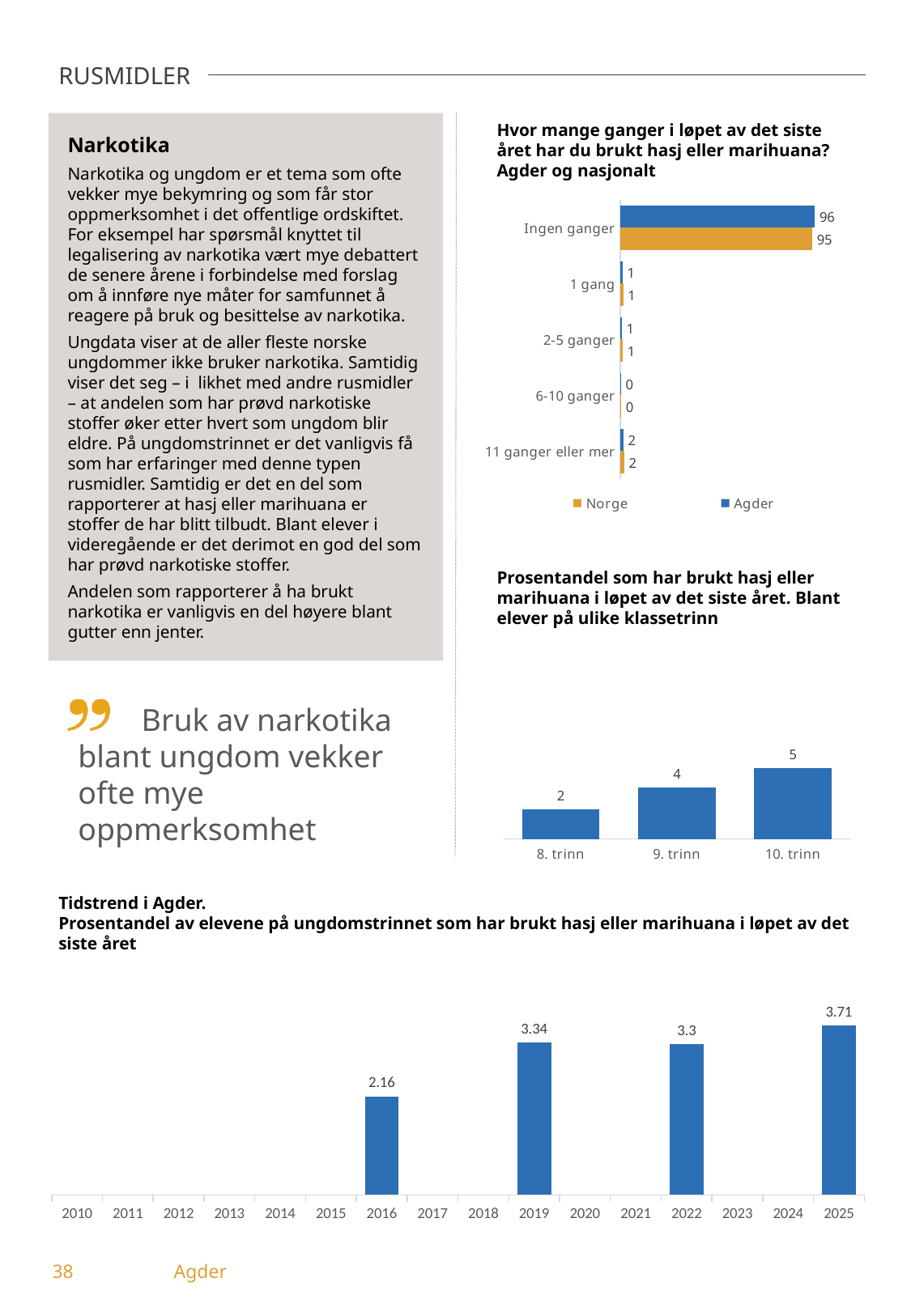
In the chart 'Hvor mange ganger i løpet av det siste året har du brukt hasj eller marihuana? Agder og nasjonalt', what is the value for Agder for '11 ganger eller mer'? 2 In the chart 'Prosentandel som har brukt hasj eller marihuana i løpet av det siste året. Blant elever på ulike klassetrinn', what is the difference between 10. trinn and 8. trinn? 3 In the chart 'Hvor mange ganger i løpet av det siste året har du brukt hasj eller marihuana? Agder og nasjonalt', what is the value for Agder for 'Ingen ganger'? 96 In the chart 'Tidstrend i Agder', which is larger, the value for 2022 or the value for 2025? 2025 In the chart 'Hvor mange ganger i løpet av det siste året har du brukt hasj eller marihuana? Agder og nasjonalt', how many categories are shown? 5 In the chart 'Tidstrend i Agder', which year has the lowest value? 2016 In the chart 'Hvor mange ganger i løpet av det siste året har du brukt hasj eller marihuana? Agder og nasjonalt', which colour represents Norge? Orange In the chart 'Hvor mange ganger i løpet av det siste året har du brukt hasj eller marihuana? Agder og nasjonalt', what is the value for Norge for 'Ingen ganger'? 95 In the chart 'Tidstrend i Agder', what is the value for 2019? 3.34 In the chart 'Prosentandel som har brukt hasj eller marihuana i løpet av det siste året. Blant elever på ulike klassetrinn', which klassetrinn has the highest value? 10. trinn In the chart 'Prosentandel som har brukt hasj eller marihuana i løpet av det siste året. Blant elever på ulike klassetrinn', what is the value for 9. trinn? 4 In the chart 'Hvor mange ganger i løpet av det siste året har du brukt hasj eller marihuana? Agder og nasjonalt', how many series does the legend list? 2